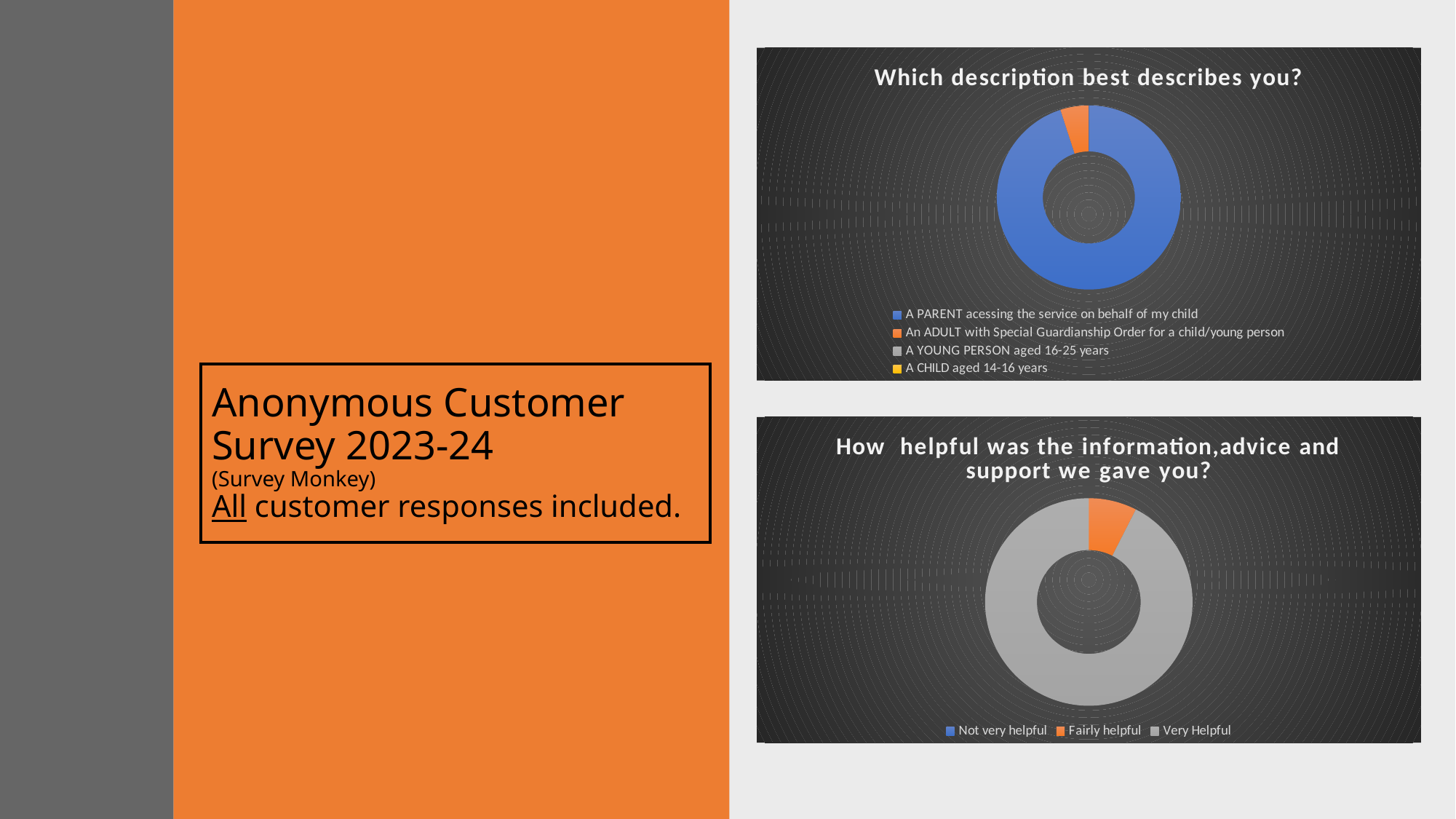
What is the title of the top chart on the slide? Which description best describes you? In the chart titled "How helpful was the information,advice and support we gave you?", which is larger: the slice for "Very Helpful" or the slice for "Fairly helpful"? Very Helpful In the chart titled "How helpful was the information,advice and support we gave you?", what colour represents "Very Helpful" in the legend? Grey What type of chart is the chart titled "Which description best describes you?"? Doughnut chart In the chart titled "How helpful was the information,advice and support we gave you?", which category has the largest slice? Very Helpful In the chart titled "How helpful was the information,advice and support we gave you?", how many entries does the legend list? 3 What type of chart is the chart titled "How helpful was the information,advice and support we gave you?"? Doughnut chart In the chart titled "Which description best describes you?", which category has the largest slice? A PARENT acessing the service on behalf of my child In the chart titled "Which description best describes you?", how many entries does the legend list? 4 In the chart titled "Which description best describes you?", which is larger: the slice for "A PARENT acessing the service on behalf of my child" or the slice for "An ADULT with Special Guardianship Order for a child/young person"? A PARENT acessing the service on behalf of my child